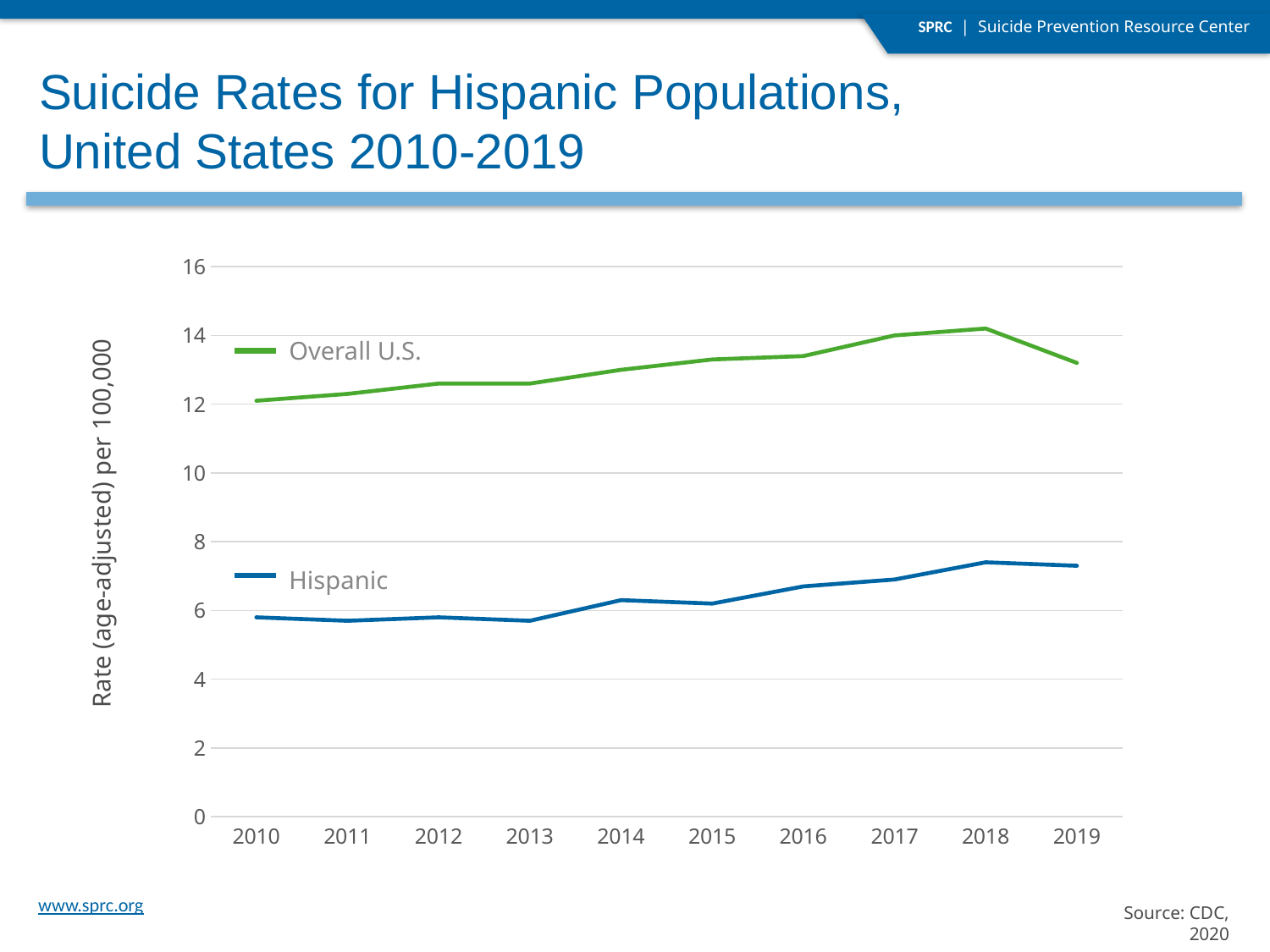
In which year is the Overall U.S. rate at its lowest? 2010 How many years are shown along the x axis of the chart? 10 What kind of chart is shown on the slide? Line chart Is the Overall U.S. rate in 2019 greater or less than 14? less Is the Overall U.S. rate in 2015 greater or less than 12? greater In which year does the Overall U.S. line reach its highest value? 2018 Does the Hispanic suicide rate generally rise or fall from 2010 to 2018? Rise Which series has the higher suicide rate across all years, Overall U.S. or Hispanic? Overall U.S. Is the Hispanic rate in 2018 greater or less than 7? greater In which year does the Hispanic line reach its highest value? 2018 How many series are plotted on the chart? 2 What is the label on the y axis of the chart? Rate (age-adjusted) per 100,000